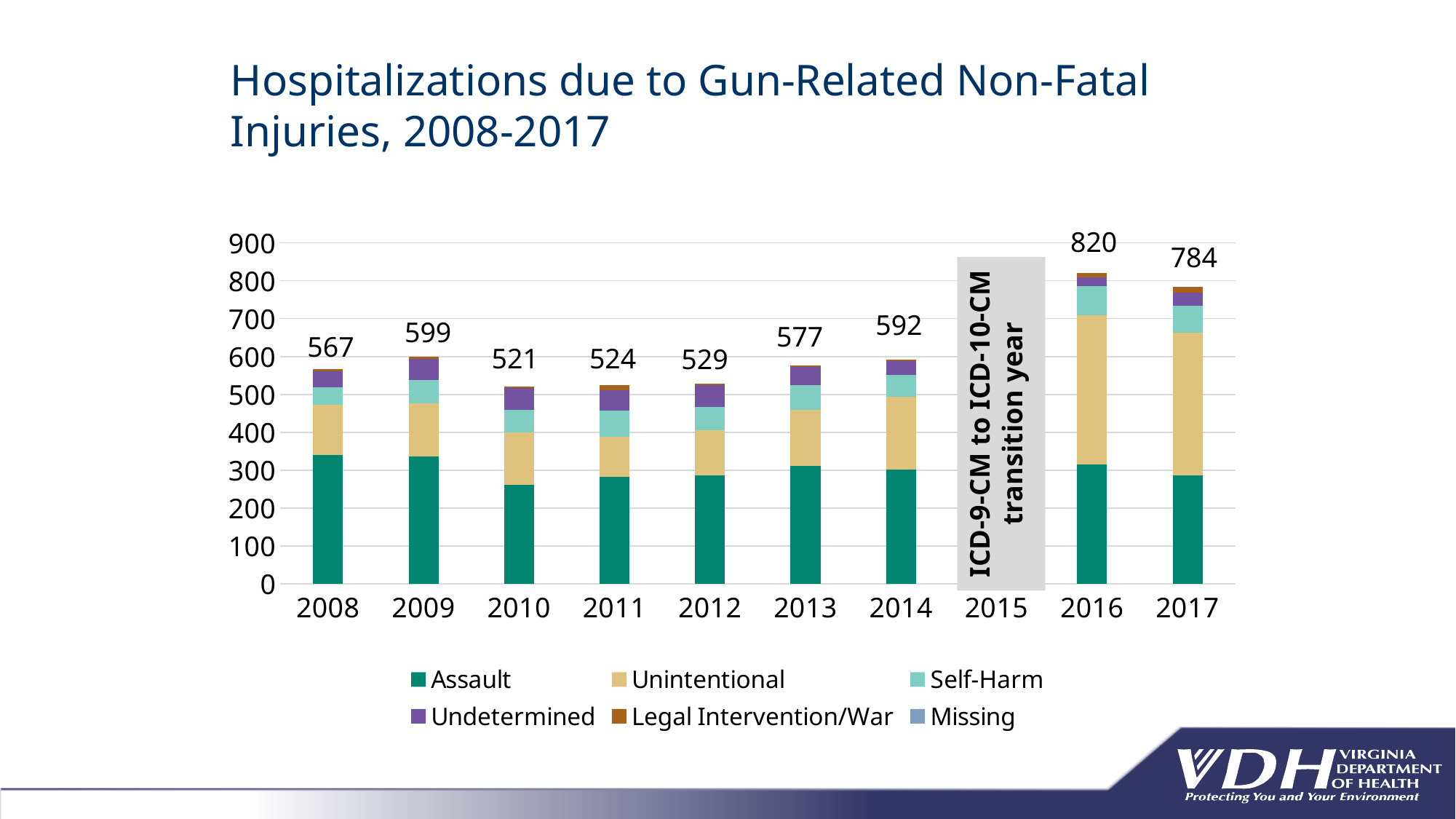
Which year has a larger total, 2013 or 2014? 2014 What is the difference between the totals for 2009 and 2008? 32 Which year is marked as the ICD-9-CM to ICD-10-CM transition year with no bar shown? 2015 How many series does the legend list? 6 Which year has the highest total hospitalizations? 2016 Is the Assault value for 2010 greater or less than 300? less What is the difference between the totals for 2016 and 2017? 36 Is the Assault value for 2008 greater or less than 300? greater What is the total number of hospitalizations shown for 2016? 820 Which year has the lowest total hospitalizations? 2010 What is the total number of hospitalizations shown for 2010? 521 What kind of chart is shown on the slide? Stacked bar chart